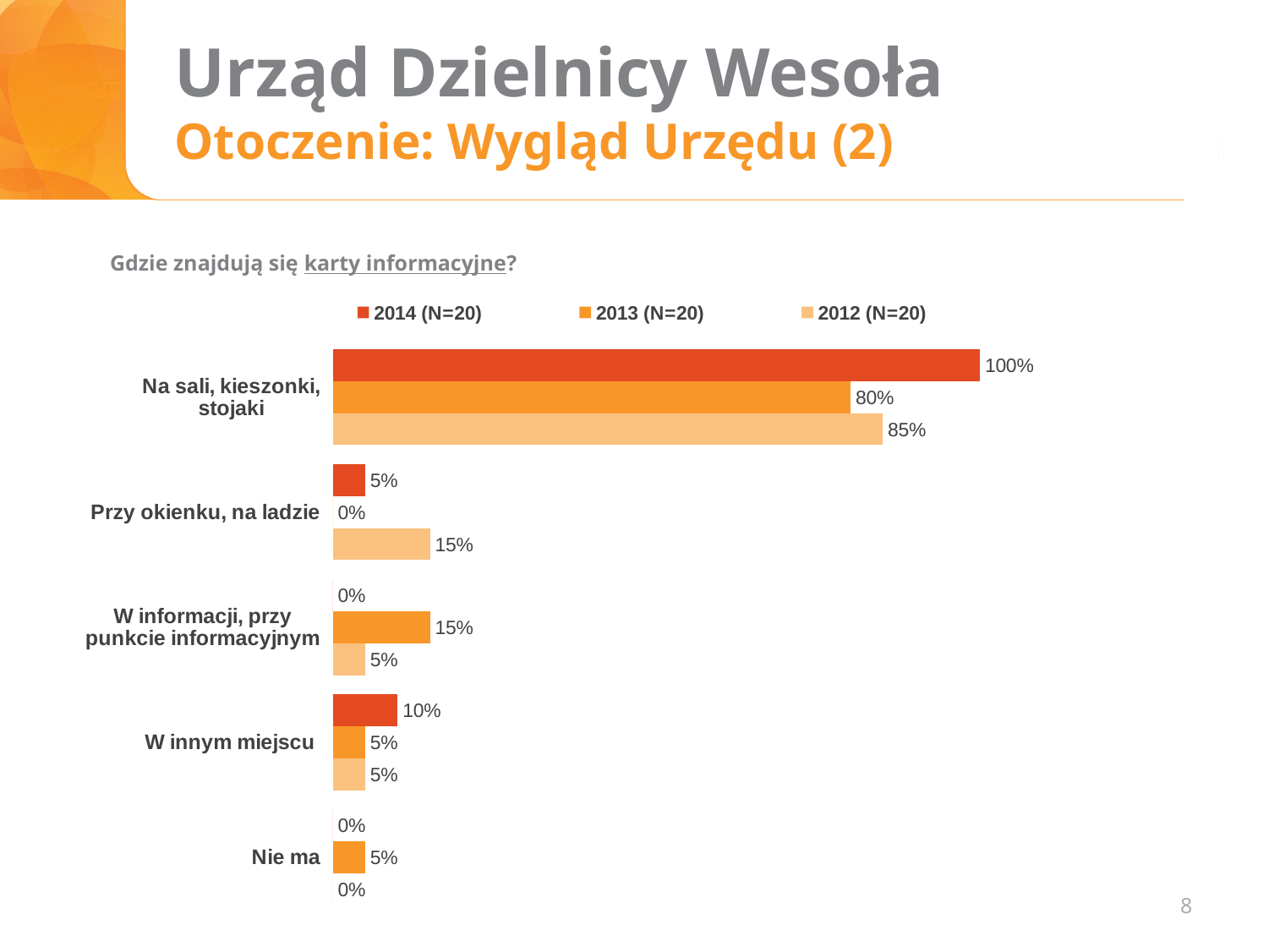
What question is the chart answering, as written above it? Gdzie znajdują się karty informacyjne? How many categories are shown on the chart? 5 What kind of chart is shown on the slide? Bar chart Which category has the highest value in the 2014 (N=20) series? Na sali, kieszonki, stojaki What is the value for 'Na sali, kieszonki, stojaki' in the 2014 (N=20) series? 100% What is the value for 'Przy okienku, na ladzie' in the 2012 (N=20) series? 15% What is the value for 'Nie ma' in the 2013 (N=20) series? 5% What is the difference between the 2014 (N=20) and 2013 (N=20) values for 'Na sali, kieszonki, stojaki'? 20% What is the value for 'W informacji, przy punkcie informacyjnym' in the 2013 (N=20) series? 15% What is the difference between the 2012 (N=20) and 2014 (N=20) values for 'Przy okienku, na ladzie'? 10% For 'W innym miejscu', which series has the larger value: 2014 (N=20) or 2013 (N=20)? 2014 (N=20) How many series does the legend list? 3